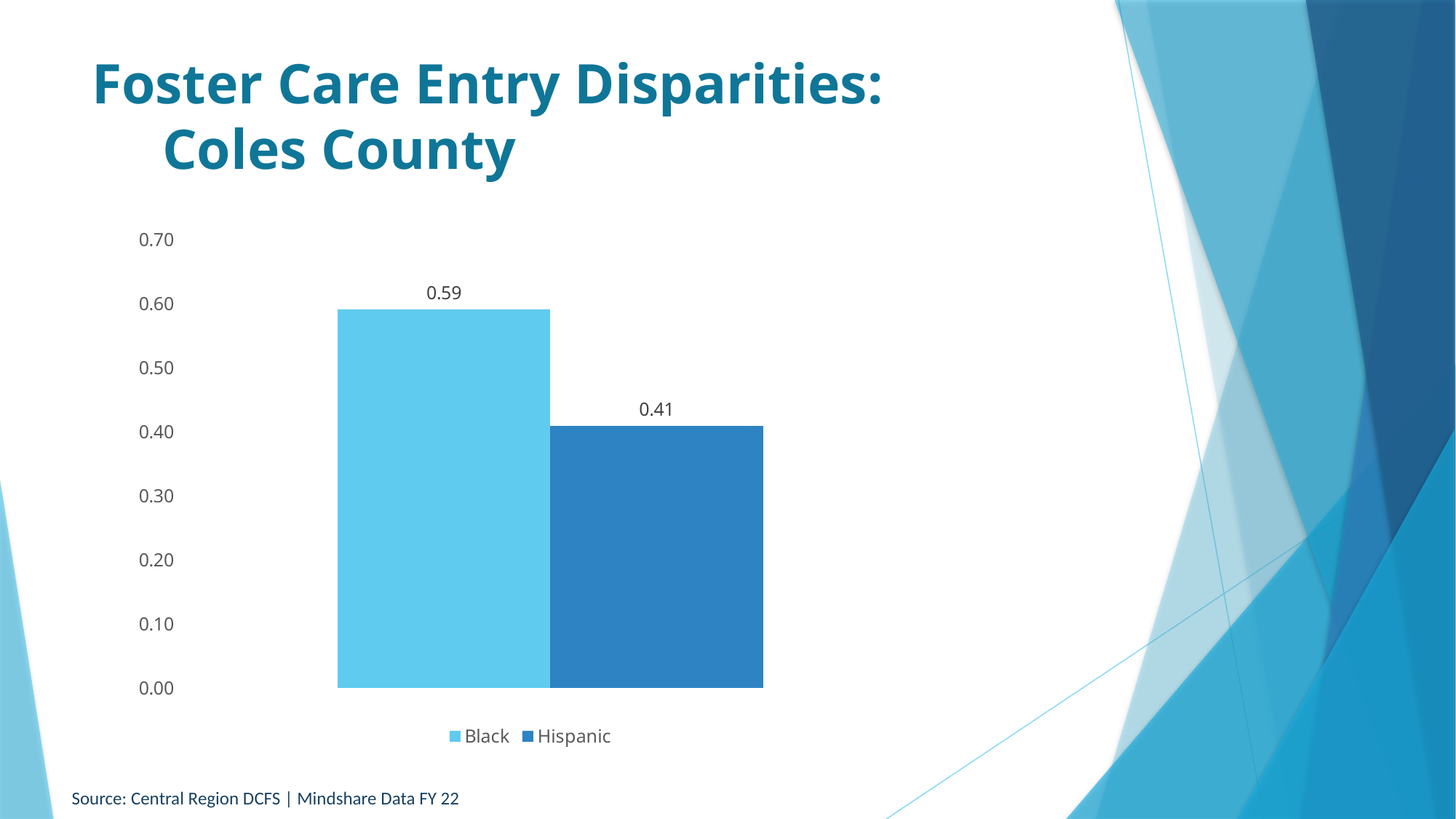
What kind of chart is shown on the slide? bar chart What is the difference between the values for Black and Hispanic? 0.18 What is the value for Black? 0.59 Is the value for Hispanic greater or less than 0.50? less How many series does the legend list? 2 What is the value for Hispanic? 0.41 Which series has the highest value? Black Is the value for Black greater or less than 0.50? greater Which is larger, the value for Black or the value for Hispanic? Black What is the title of the slide containing the chart? Foster Care Entry Disparities: Coles County Which series has the lowest value? Hispanic How many bars are plotted on the chart? 2